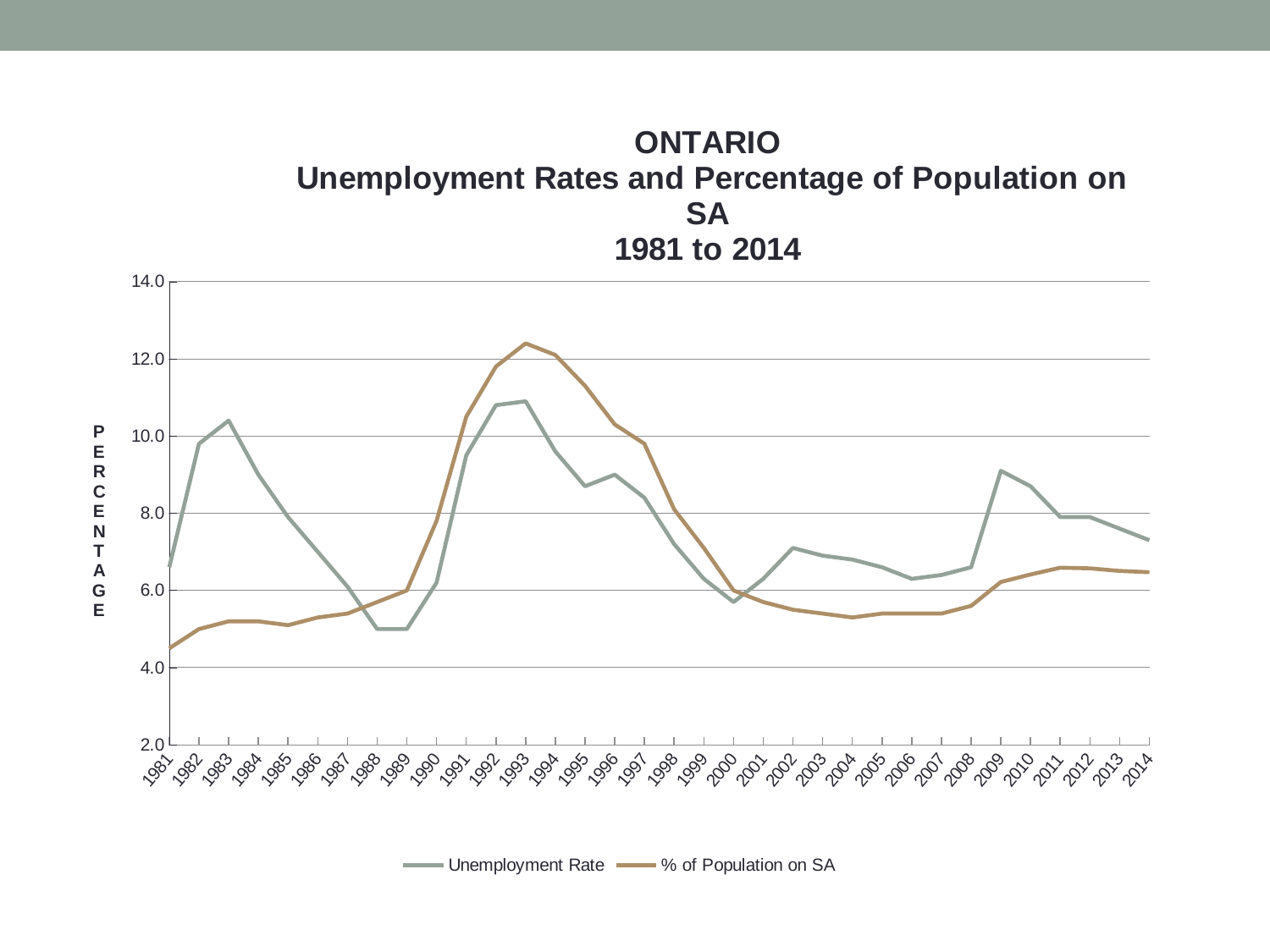
How many series does the legend list? 2 Which year has the highest value for % of Population on SA? 1993 How many years are plotted along the x axis? 34 What kind of chart is shown on the slide? Line chart In 1983, which series has the larger value: Unemployment Rate or % of Population on SA? Unemployment Rate In 1993, which series has the larger value: Unemployment Rate or % of Population on SA? % of Population on SA Is the % of Population on SA for 1993 greater or less than 12.0? greater Which year has the lowest value for % of Population on SA? 1981 Is the % of Population on SA for 2004 greater or less than 6.0? less Is the Unemployment Rate for 1983 greater or less than 10.0? greater Does the Unemployment Rate rise or fall from 2009 to 2014? fall